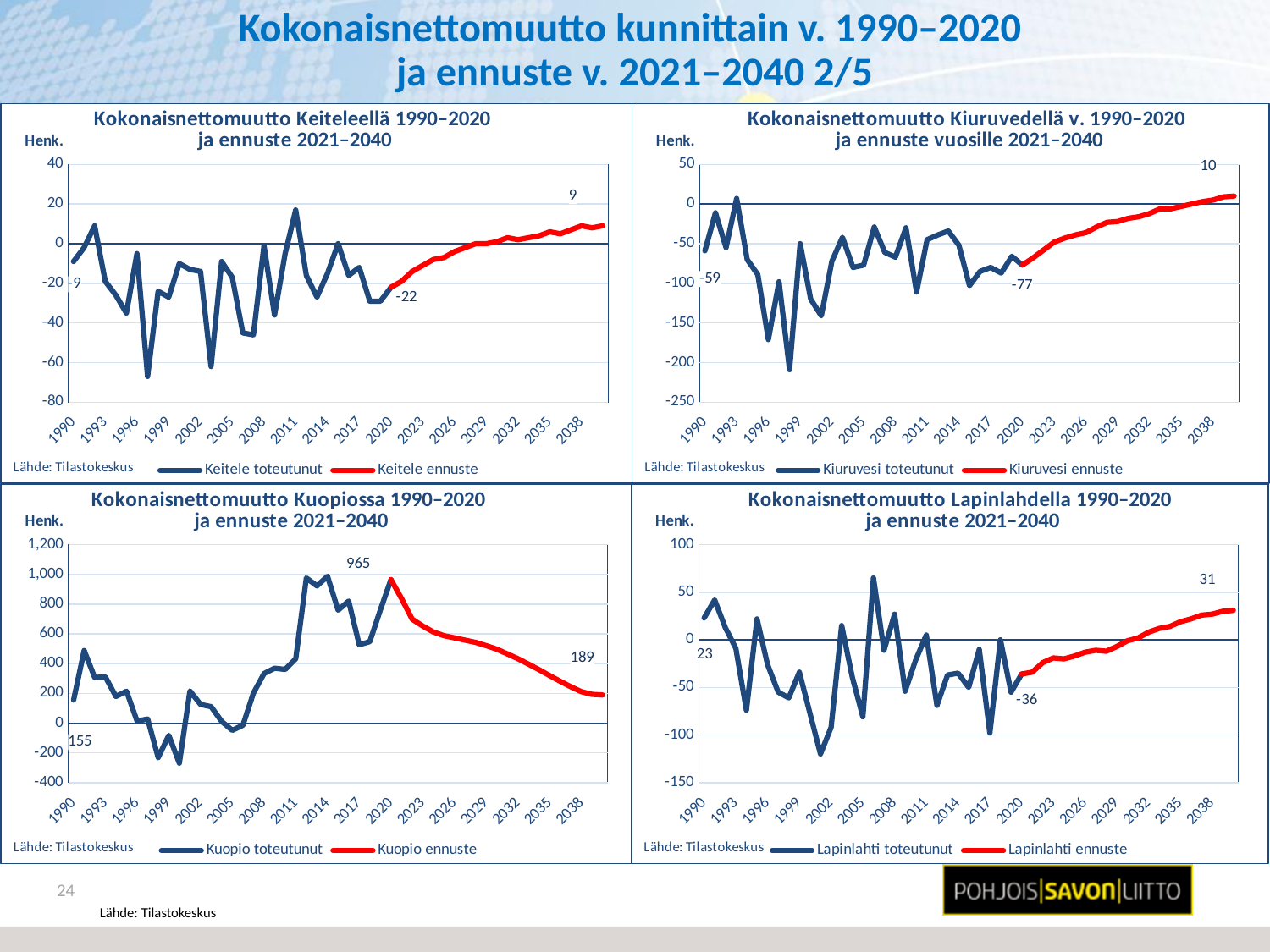
How many series does the legend of the Keitele chart (top left) list? 2 In the Kiuruvesi chart (top right), is the lowest point of the realised line (around 1998) greater or less than -150? less In the Kuopio chart (bottom left), does the forecast line rise or fall from 2021 to 2040? fall What type of chart is used in the Lapinlahti chart (bottom right)? line chart In the Lapinlahti chart (bottom right), which is larger, the 1990 value or the 2020 value? 1990 value (23) In the Keitele chart (top left), what is the labelled forecast value for 2040? 9 In the Lapinlahti chart (bottom right), what is the labelled forecast value for 2040? 31 In the Kiuruvesi chart (top right), what is the labelled value for 1990? -59 In the Kuopio chart (bottom left), what is the difference between the 2020 value (965) and the 2040 forecast value (189)? 776 In the Kiuruvesi chart (top right), what is the labelled value for 2020? -77 In the Keitele chart (top left), what is the labelled value for 2020? -22 In the Kuopio chart (bottom left), what is the labelled value for 2020? 965